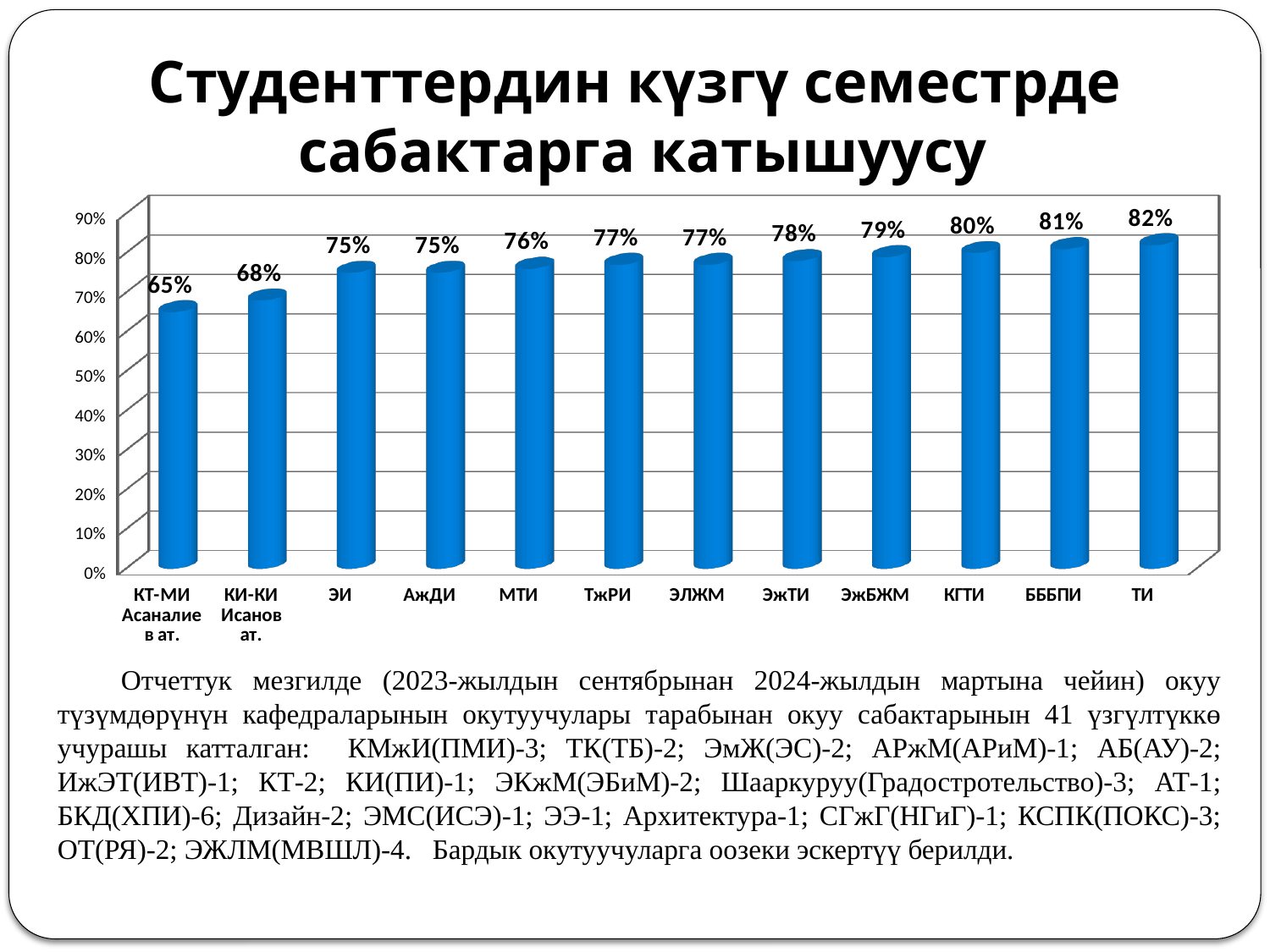
Do the values rise or fall from left to right along the x axis? rise Is the value for КИ-КИ Исанов ат. greater or less than 70%? less What is the value for МТИ? 76% Which is larger, the value for БББПИ or the value for ЭжТИ? БББПИ What is the value for КГТИ? 80% What kind of chart is shown on the slide? bar chart How many categories are shown on the chart? 12 What is the value for ТИ? 82% What is the difference between the values for ТИ and КТ-МИ Асаналиев ат.? 17% What is the difference between the values for ЭжБЖМ and КИ-КИ Исанов ат.? 11% Which category has the highest value? ТИ Which category has the lowest value? КТ-МИ Асаналиев ат.